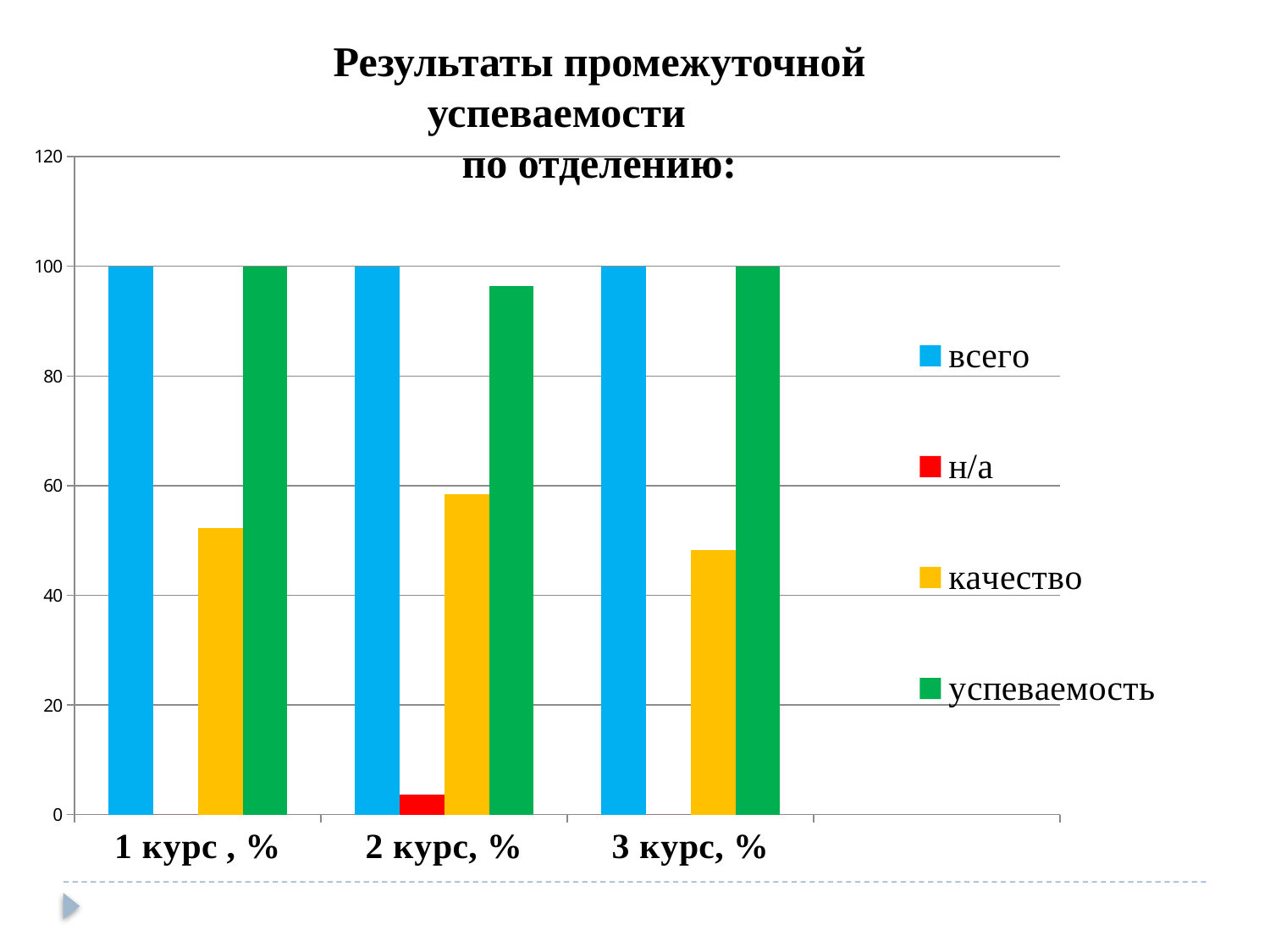
Is the value of успеваемость for 2 курс greater or less than 80? greater What is the value of всего for 1 курс? 100 How many categories are shown on the x axis? 3 What is the value of успеваемость for 3 курс? 100 Is the value of качество for 1 курс greater or less than 60? less Is the value of н/а for 2 курс greater or less than 20? less How many series does the legend list? 4 Which category has the lowest value for качество? 3 курс Which category has the highest value for качество? 2 курс Which is larger, качество for 2 курс or качество for 3 курс? 2 курс What kind of chart is shown on the slide? bar chart Which series is shown in red in the legend? н/а